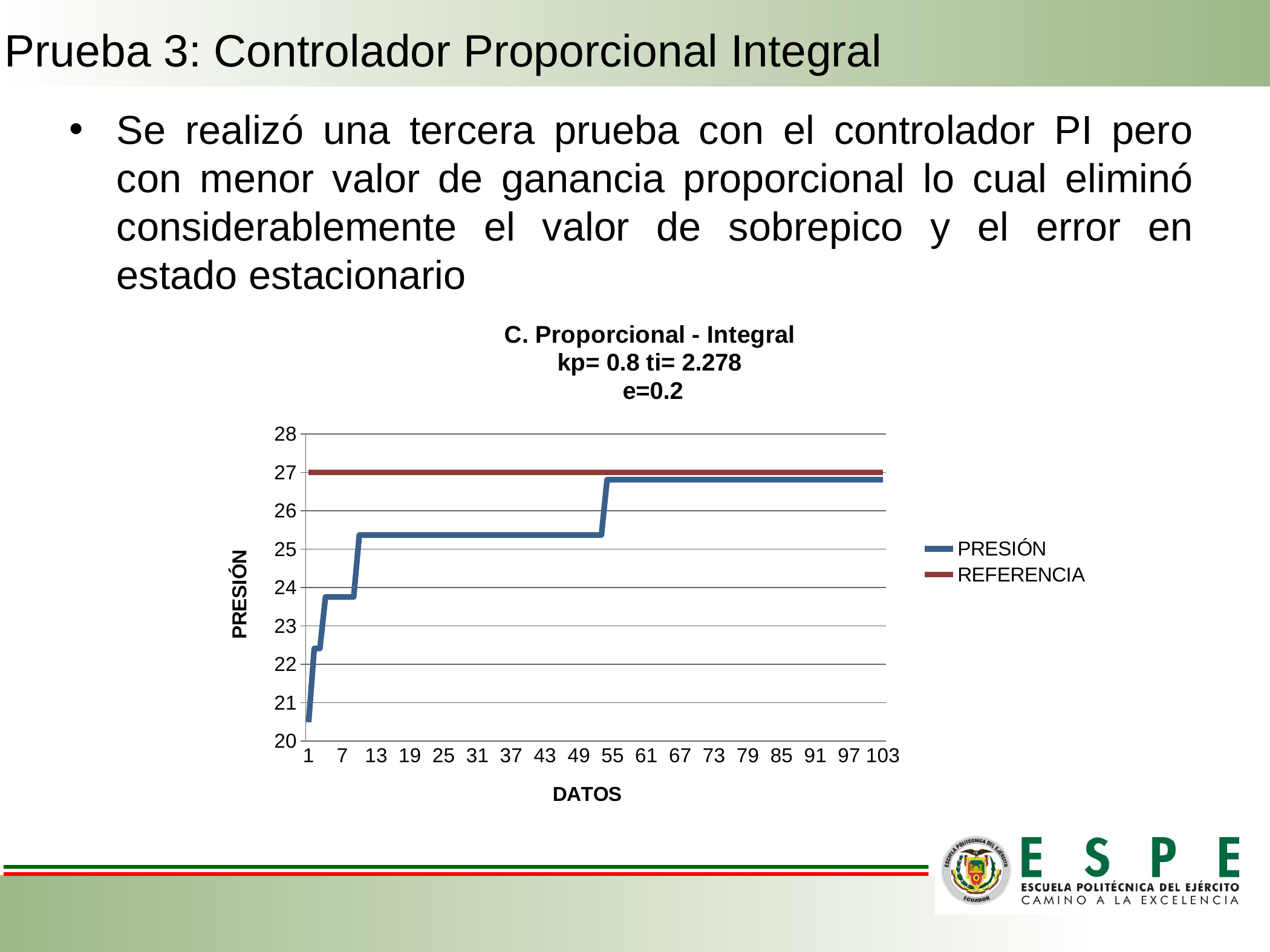
What are the two series named in the chart legend? PRESIÓN and REFERENCIA Which series has the larger value at DATOS = 25, PRESIÓN or REFERENCIA? REFERENCIA How many series does the chart legend list? 2 Is the PRESIÓN value at DATOS = 31 greater or less than 26? less Is the PRESIÓN value at DATOS = 85 greater or less than 26? greater Is the REFERENCIA value greater or less than 26? greater Does the PRESIÓN series rise or fall along the x axis overall? rise What kind of chart is shown on the slide? line chart What is the label of the vertical axis? PRESIÓN What is the title of the chart? C. Proporcional - Integral kp= 0.8 ti= 2.278 e=0.2